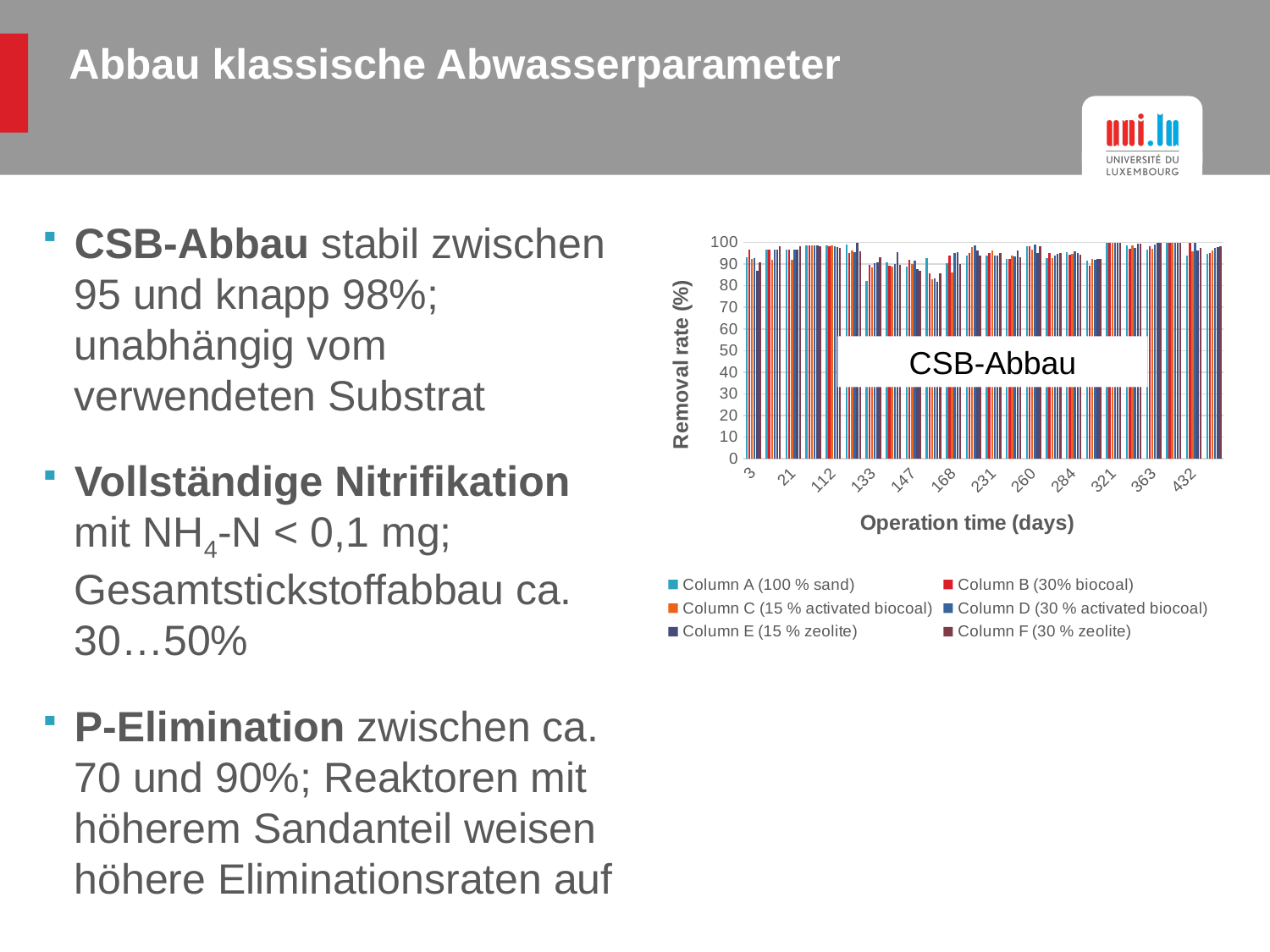
Is the value for Column F (30 % zeolite) at operation day 432 greater or less than 50? greater What is the title shown inside the chart? CSB-Abbau How many series does the legend of the chart list? 6 Is the value for Column B (30% biocoal) at operation day 21 greater or less than 60? greater What type of chart is shown on the slide? bar chart Is the value for Column D (30 % activated biocoal) at operation day 321 greater or less than 70? greater According to the legend, which column contains 30% biocoal? Column B